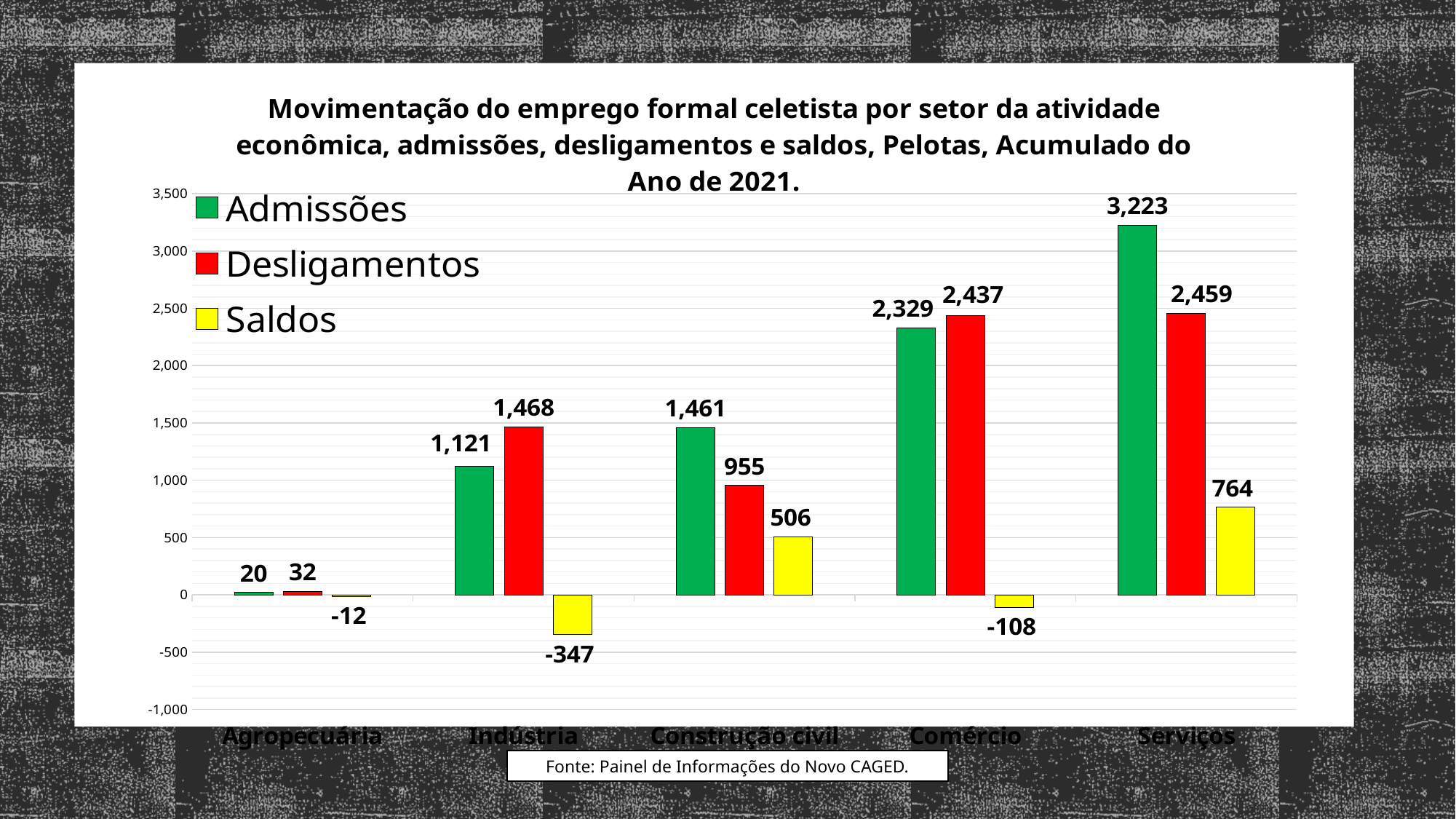
Is the Admissões value for Comércio greater or less than 2,000? greater What kind of chart is shown on the slide? Bar chart Which sector has the lowest Saldos value? Indústria Which sector has the highest Admissões value? Serviços What is the value of Desligamentos for Indústria? 1,468 What is the value of Admissões for Serviços? 3,223 What is the value of Saldos for Construção civil? 506 How many series does the legend list? 3 How many sectors are shown on the x axis? 5 What is the difference between Desligamentos and Admissões for Comércio? 108 Which is larger for Construção civil, Admissões or Desligamentos? Admissões What is the value of Saldos for Comércio? -108